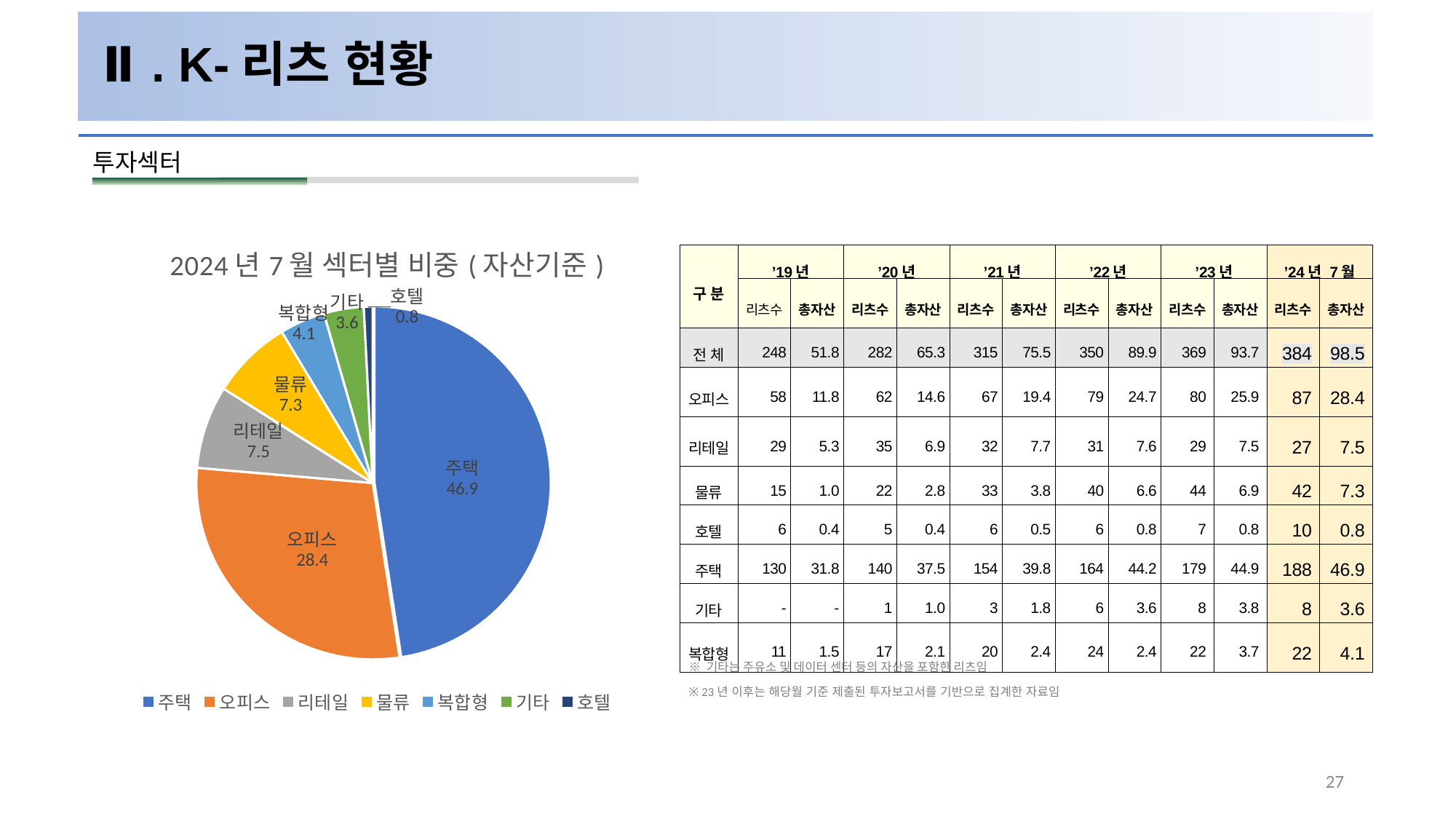
How many entries does the pie chart legend list? 7 Which sector has the largest slice in the pie chart? 주택 How many slices does the pie chart have? 7 What is the difference between the values for 주택 and 오피스 in the pie chart? 18.5 What is the value shown for 물류 in the pie chart? 7.3 Which sector has the smallest slice in the pie chart? 호텔 What is the title of the pie chart? 2024년 7월 섹터별 비중 (자산기준) What is the value shown for 호텔 in the pie chart? 0.8 Which is larger in the pie chart, 복합형 or 기타? 복합형 What type of chart is shown on the slide? pie chart What is the value shown for 오피스 in the pie chart? 28.4 What is the value shown for 주택 in the pie chart? 46.9